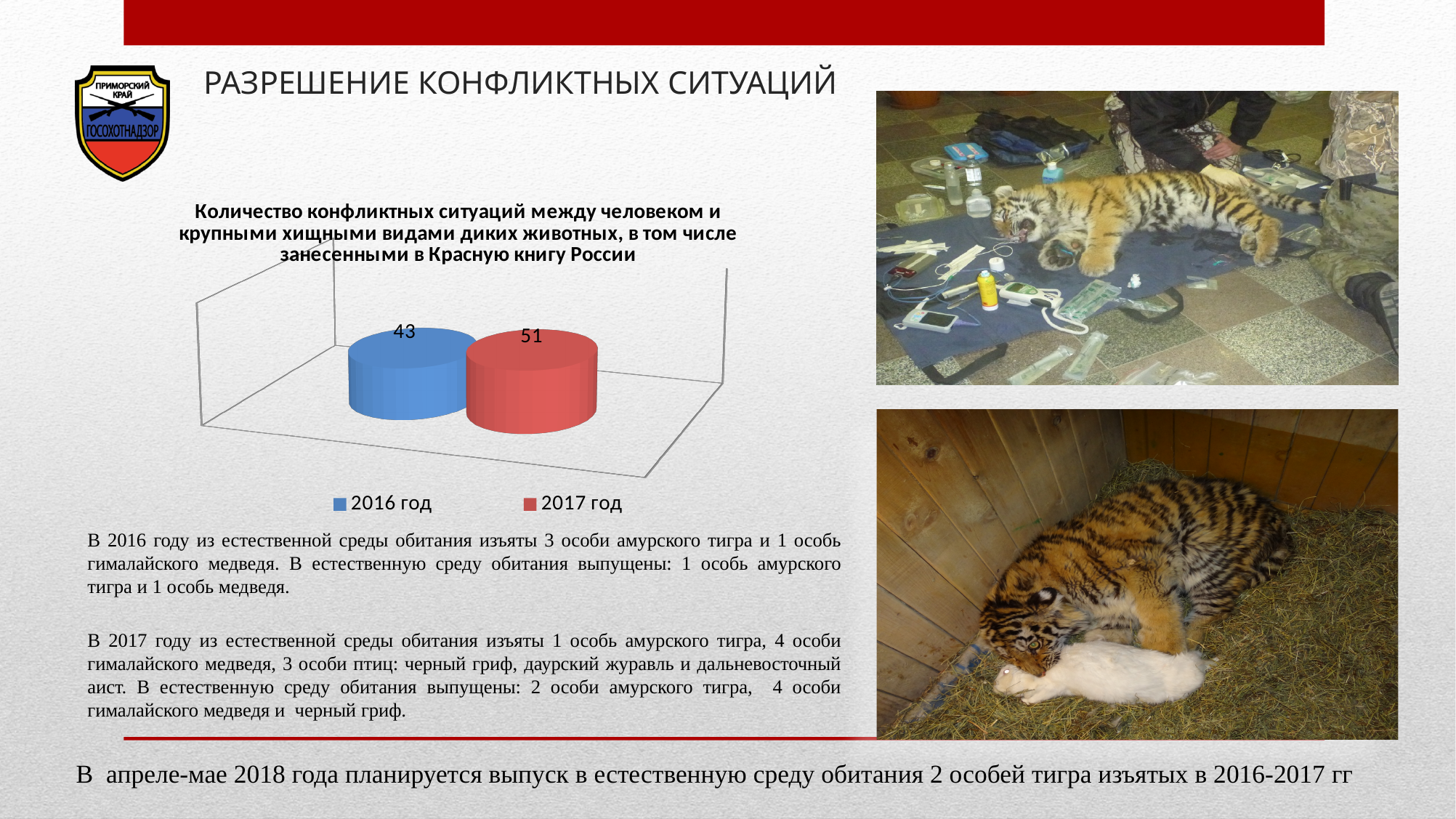
What is the value for 2016 год in the chart? 43 How many series does the chart legend list? 2 Is the value for 2017 год larger or smaller than the value for 2016 год? larger Which year has the higher number of conflict situations in the chart? 2017 год What kind of chart is shown on the slide? bar chart What colour is the bar for 2017 год? red By how much does the value for 2017 год exceed the value for 2016 год? 8 What is the value for 2017 год in the chart? 51 What colour is the bar for 2016 год? blue Do the values rise or fall from 2016 год to 2017 год? rise Which year has the lower number of conflict situations in the chart? 2016 год How many bars are plotted in the chart? 2